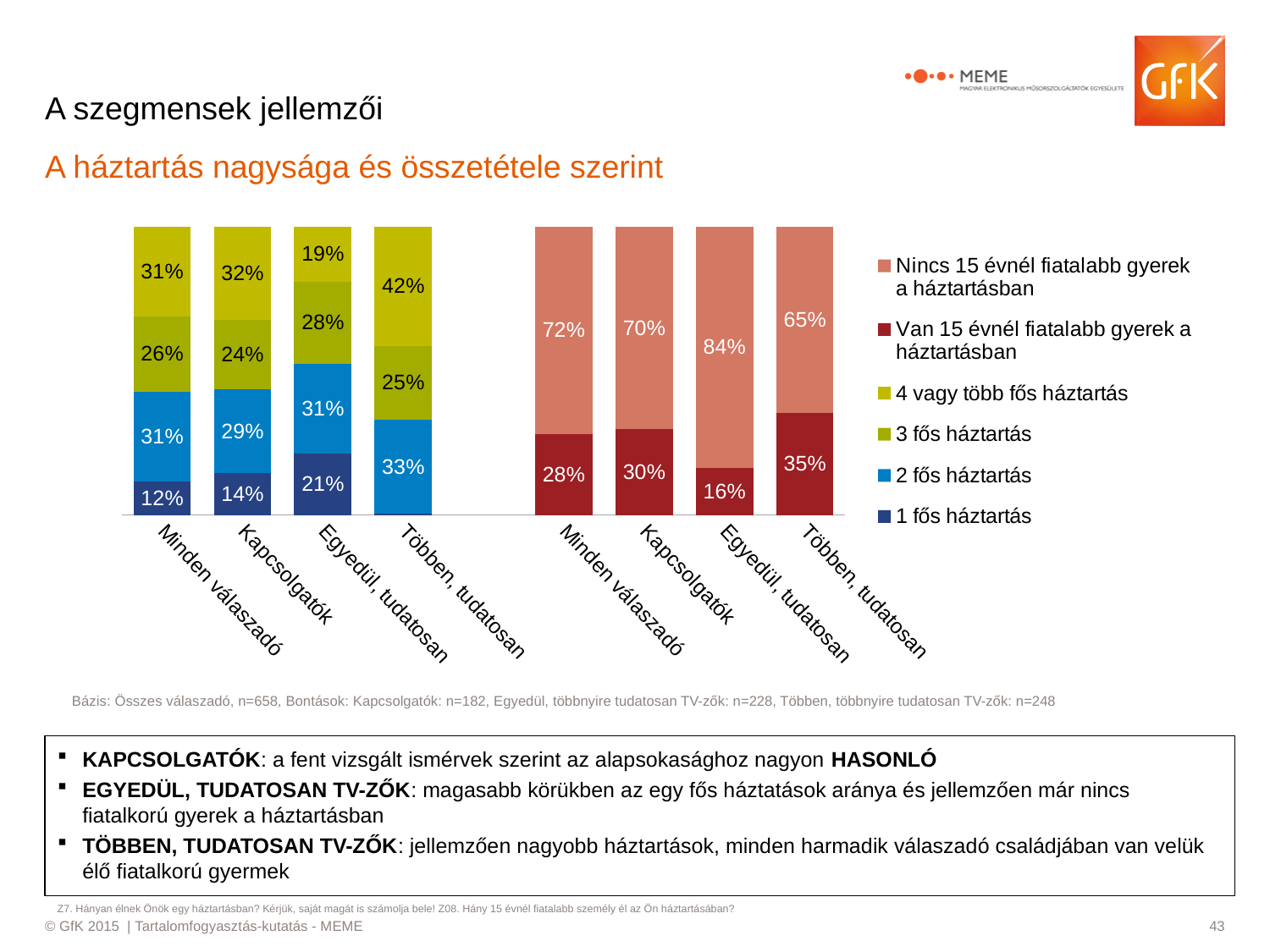
In the left-hand chart, what is the share of 1 fős háztartás for 'Egyedül, tudatosan'? 21% In the right-hand chart, which category has the highest share of households with a child under 15 (Van 15 évnél fiatalabb gyerek a háztartásban)? Többen, tudatosan How many categories are shown on the x axis of the left-hand chart? 4 How many entries does the legend on the slide list? 6 In the left-hand chart, what is the share of 4 vagy több fős háztartás for 'Többen, tudatosan'? 42% What type of chart is the right-hand chart? Stacked bar chart In the right-hand chart, what is the difference in percentage points between the 'Van 15 évnél fiatalabb gyerek' share for 'Többen, tudatosan' and for 'Egyedül, tudatosan'? 19 percentage points In the left-hand chart, which category has the lowest share of 4 vagy több fős háztartás? Egyedül, tudatosan In the left-hand chart, what is the difference in percentage points between the 1 fős háztartás share for 'Egyedül, tudatosan' and for 'Minden válaszadó'? 9 percentage points In the left-hand chart, which is larger: the 3 fős háztartás share for 'Minden válaszadó' or for 'Kapcsolgatók'? Minden válaszadó In the right-hand chart, what percentage of 'Egyedül, tudatosan' respondents have no child under 15 in the household (Nincs 15 évnél fiatalabb gyerek a háztartásban)? 84% In the right-hand chart, which category has the lowest share of households with a child under 15 (Van 15 évnél fiatalabb gyerek a háztartásban)? Egyedül, tudatosan